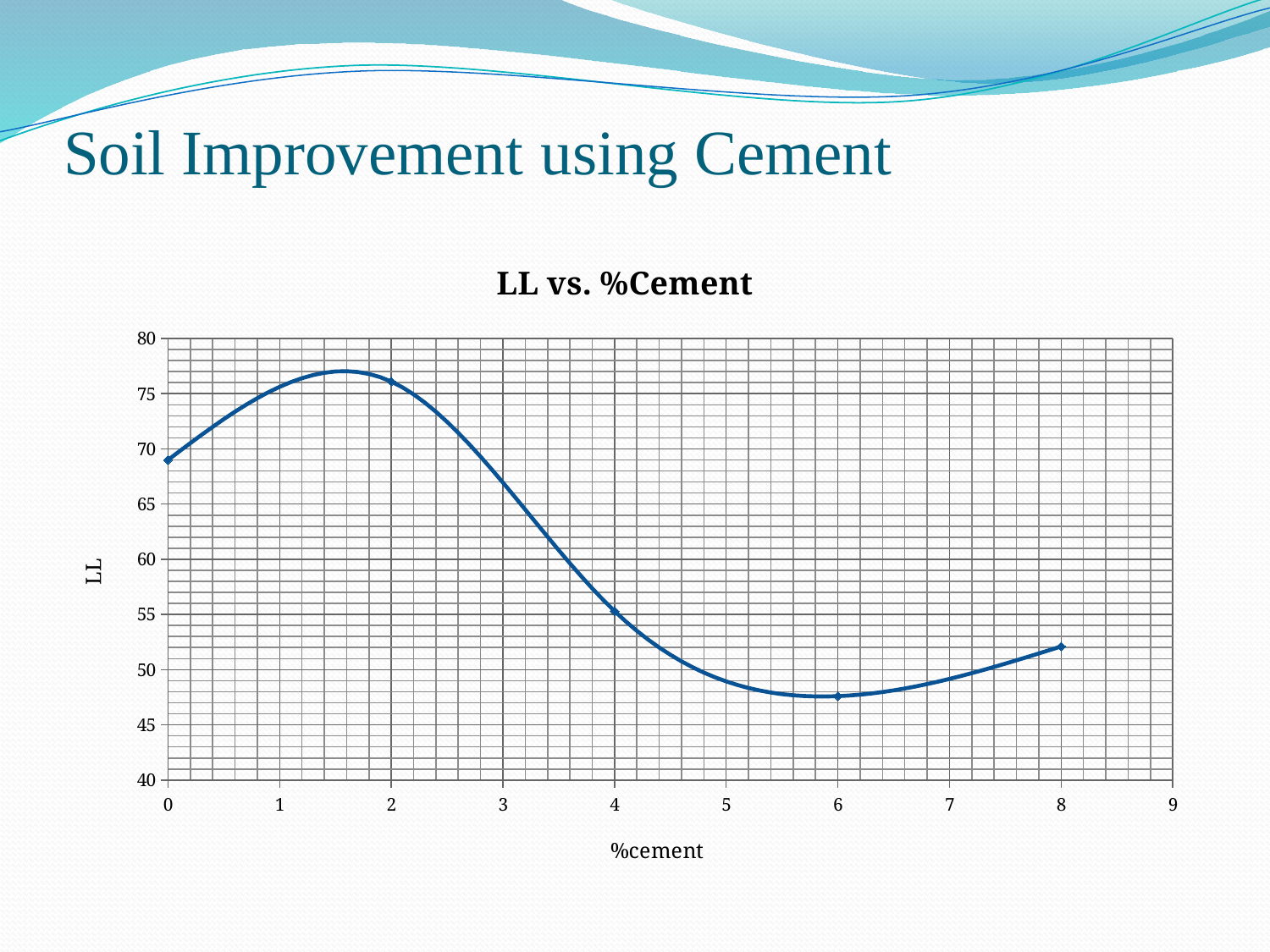
What kind of chart is shown on the slide? line chart At which %cement value is LL lowest? 6 Is the LL value at 6% cement greater or less than 50? less What is the label of the x axis? %cement Is the LL value at 4% cement greater or less than 60? less At which %cement value is LL highest? 2 What is the title of the chart? LL vs. %Cement Does LL rise or fall as %cement increases from 2 to 6? fall How many data points are plotted on the line? 5 Which has the larger LL value: 0% cement or 8% cement? 0% cement Is the LL value at 8% cement greater or less than 50? greater